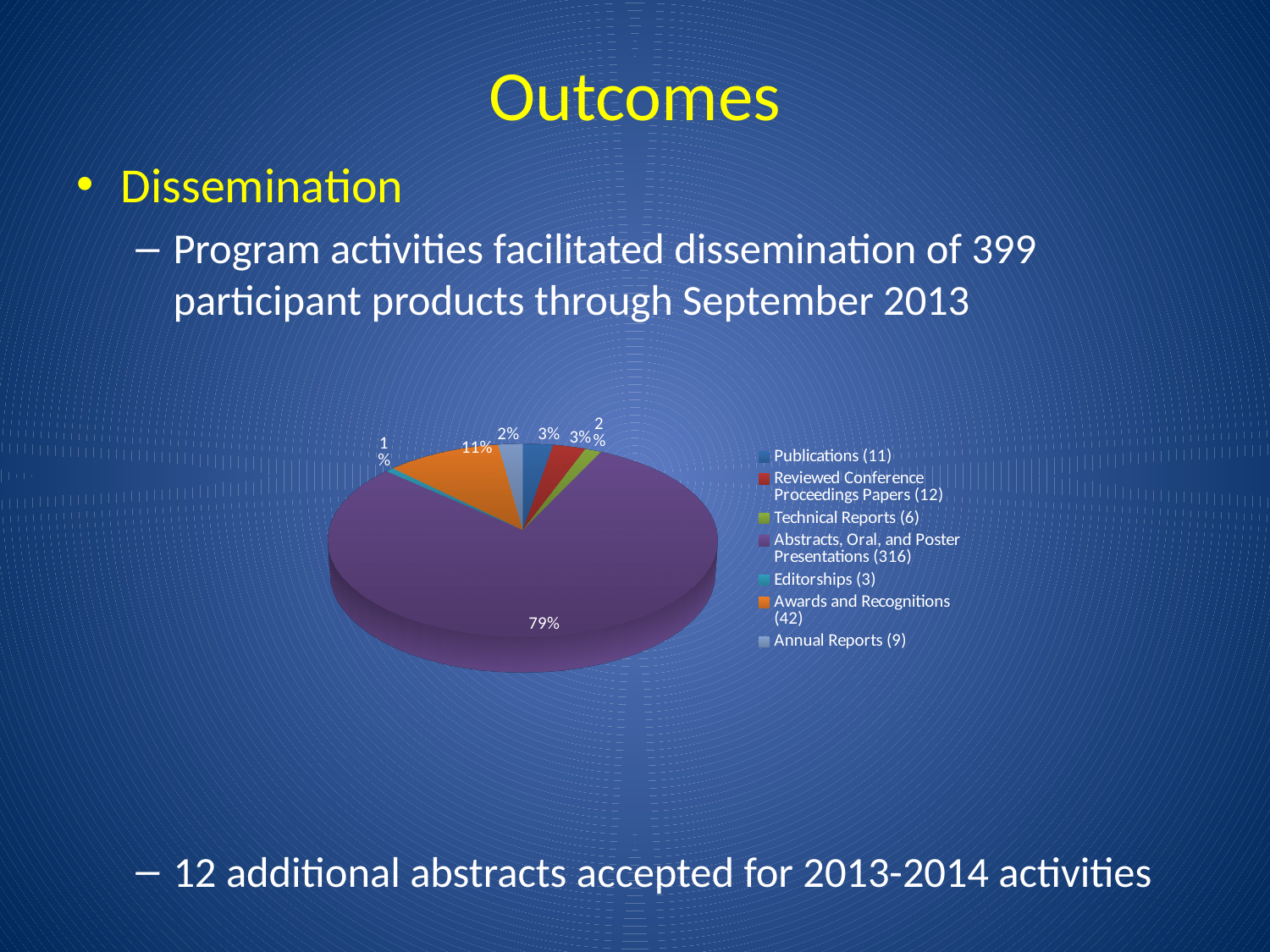
What colour is the slice for Abstracts, Oral, and Poster Presentations? purple What share of the pie does Abstracts, Oral, and Poster Presentations represent? 79% According to the legend, how many Awards and Recognitions were there? 42 Which is larger, the slice for Awards and Recognitions or the slice for Publications? Awards and Recognitions What is the difference between the number of Abstracts, Oral, and Poster Presentations (316) and the number of Awards and Recognitions (42) shown in the legend? 274 How many categories does the pie chart's legend list? 7 According to the legend, how many Technical Reports were there? 6 What kind of chart is shown on the slide? pie chart Which category has the smallest slice of the pie? Editorships According to the legend, how many Abstracts, Oral, and Poster Presentations were there? 316 Which category has the largest slice of the pie? Abstracts, Oral, and Poster Presentations What share of the pie does Awards and Recognitions represent? 11%